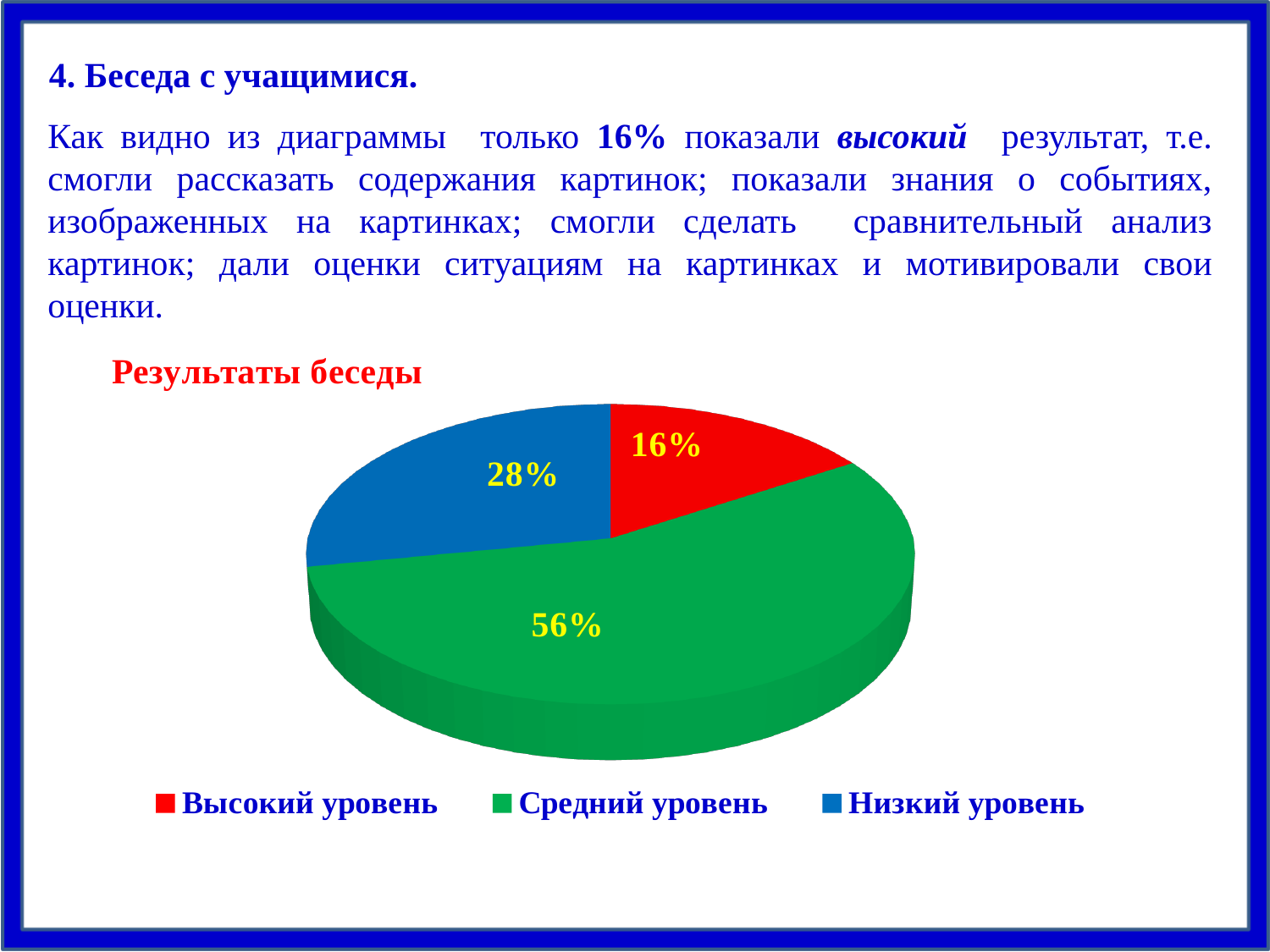
How many categories does the legend list? 3 What share of the pie does Средний уровень have? 56% What is the difference between the shares of Низкий уровень and Высокий уровень? 12% What share of the pie does Высокий уровень have? 16% What is the difference between the shares of Средний уровень and Низкий уровень? 28% Which is larger, the share of Низкий уровень or the share of Высокий уровень? Низкий уровень Which category has the largest slice of the pie? Средний уровень What share of the pie does Низкий уровень have? 28% Which category has the smallest slice of the pie? Высокий уровень What type of chart is shown on the slide? Pie chart Which colour represents Низкий уровень in the chart? Blue What is the title of the chart? Результаты беседы